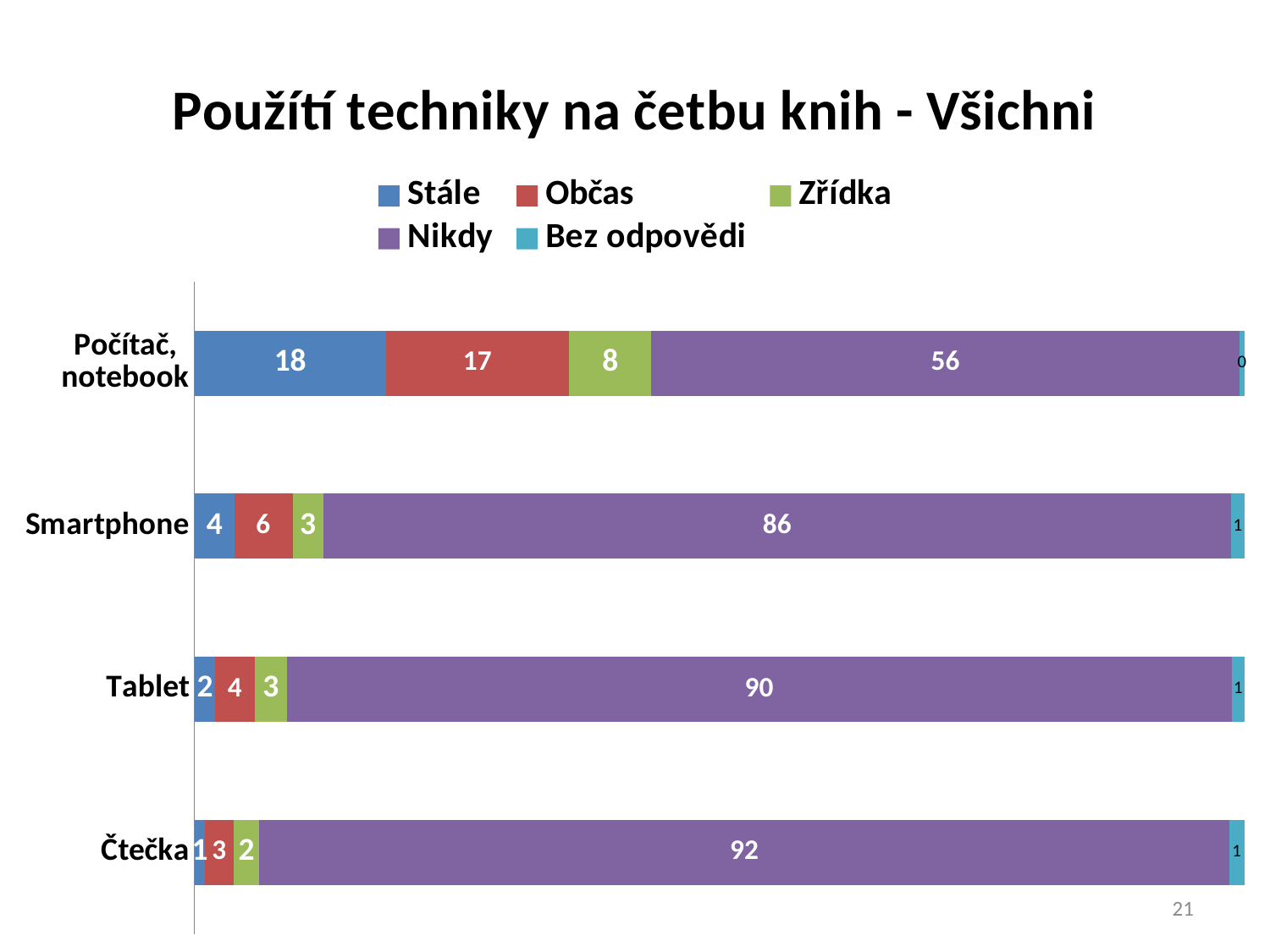
What is the value of 'Nikdy' for 'Smartphone'? 86 How many categories are shown on the chart? 4 What is the difference between the 'Nikdy' values for 'Tablet' and 'Počítač, notebook'? 34 Which category has the highest 'Nikdy' value? Čtečka Which category has the lowest 'Stále' value? Čtečka What is the value of 'Občas' for 'Tablet'? 4 How many series does the legend list? 5 What is the title of the chart? Použítí techniky na četbu knih - Všichni What type of chart is shown on the slide? Stacked bar chart Which is larger: the 'Občas' value for 'Smartphone' or for 'Čtečka'? Smartphone What is the total of the stacked bar for 'Smartphone'? 100 What is the value of 'Stále' for 'Počítač, notebook'? 18